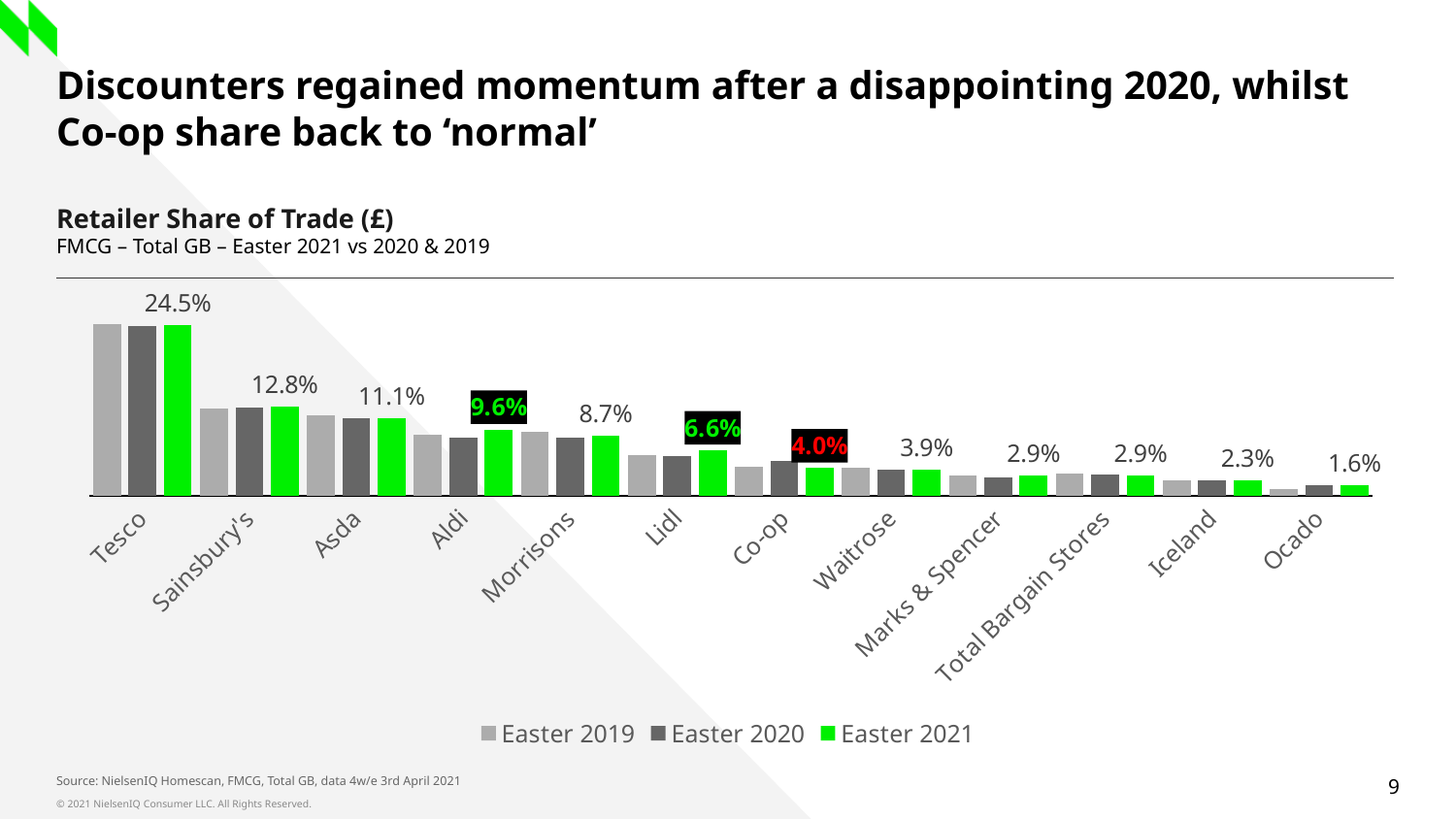
What type of chart is shown on the slide? Bar chart Do the Easter 2021 share values rise or fall moving from left to right along the x axis? Fall What is the Easter 2021 share of trade for Tesco? 24.5% Which retailer has the highest Easter 2021 share of trade? Tesco Which has the larger Easter 2021 share of trade, Lidl or Morrisons? Morrisons What is the Easter 2021 share of trade for Co-op? 4.0% What is the Easter 2021 share of trade for Ocado? 1.6% How many series does the legend list? 3 What is the Easter 2021 share of trade for Aldi? 9.6% Which retailer has the lowest Easter 2021 share of trade? Ocado What is the difference between the Easter 2021 shares of Tesco and Sainsbury's? 11.7 percentage points How many retailers are shown on the x axis? 12